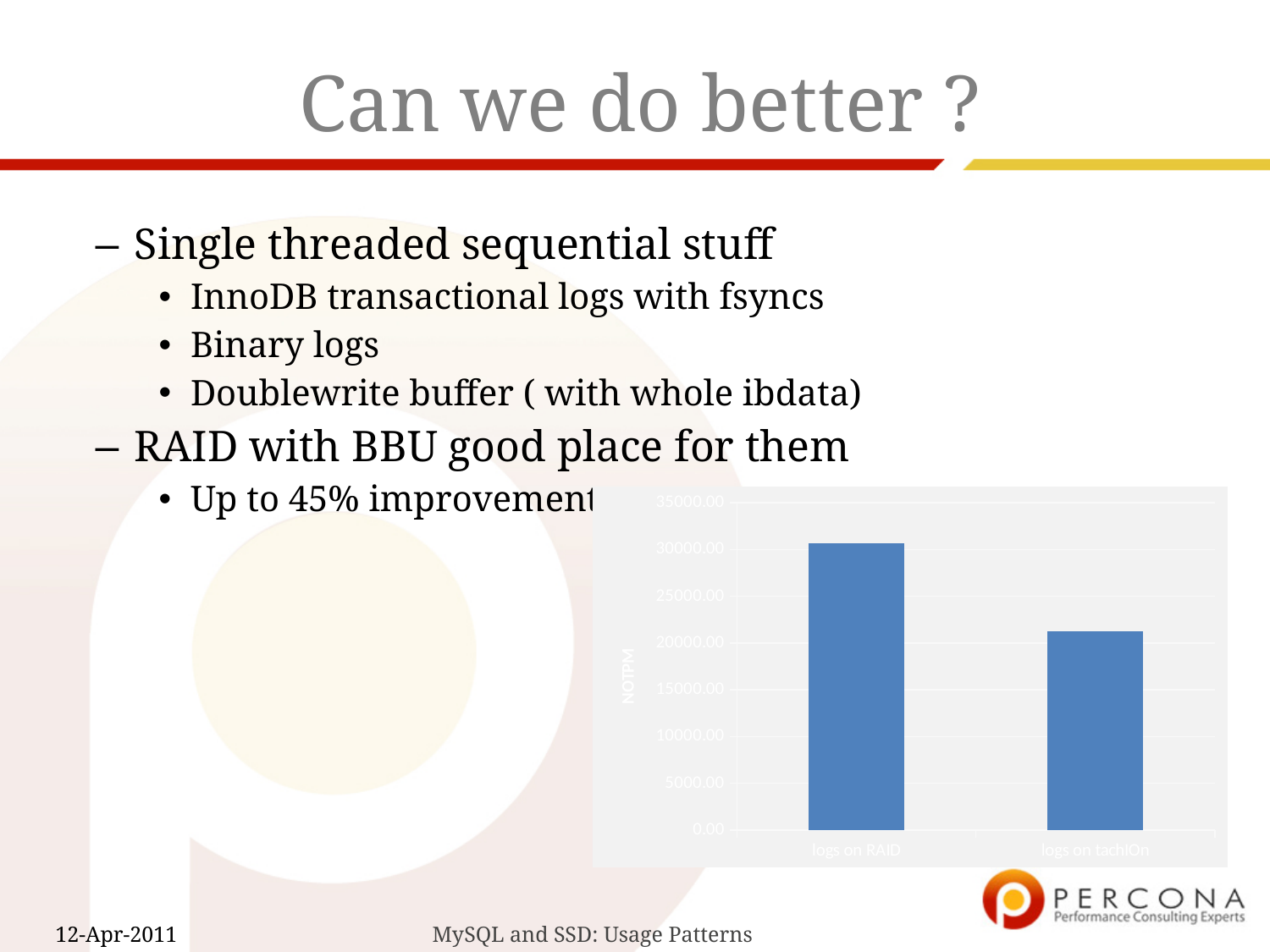
Is the value for logs on tachIOn greater or less than 25000.00? less Which category has the highest NOTPM value? logs on RAID What kind of chart is shown on the slide? bar chart How many bars are plotted in the chart? 2 What is the label on the vertical axis of the chart? NOTPM Which category has the lowest NOTPM value? logs on tachIOn Which is larger, the value for logs on RAID or the value for logs on tachIOn? logs on RAID Is the value for logs on RAID greater or less than 25000.00? greater Is the value for logs on tachIOn greater or less than 15000.00? greater What is the highest tick value shown on the vertical axis? 35000.00 Do the values rise or fall from left to right across the categories? fall